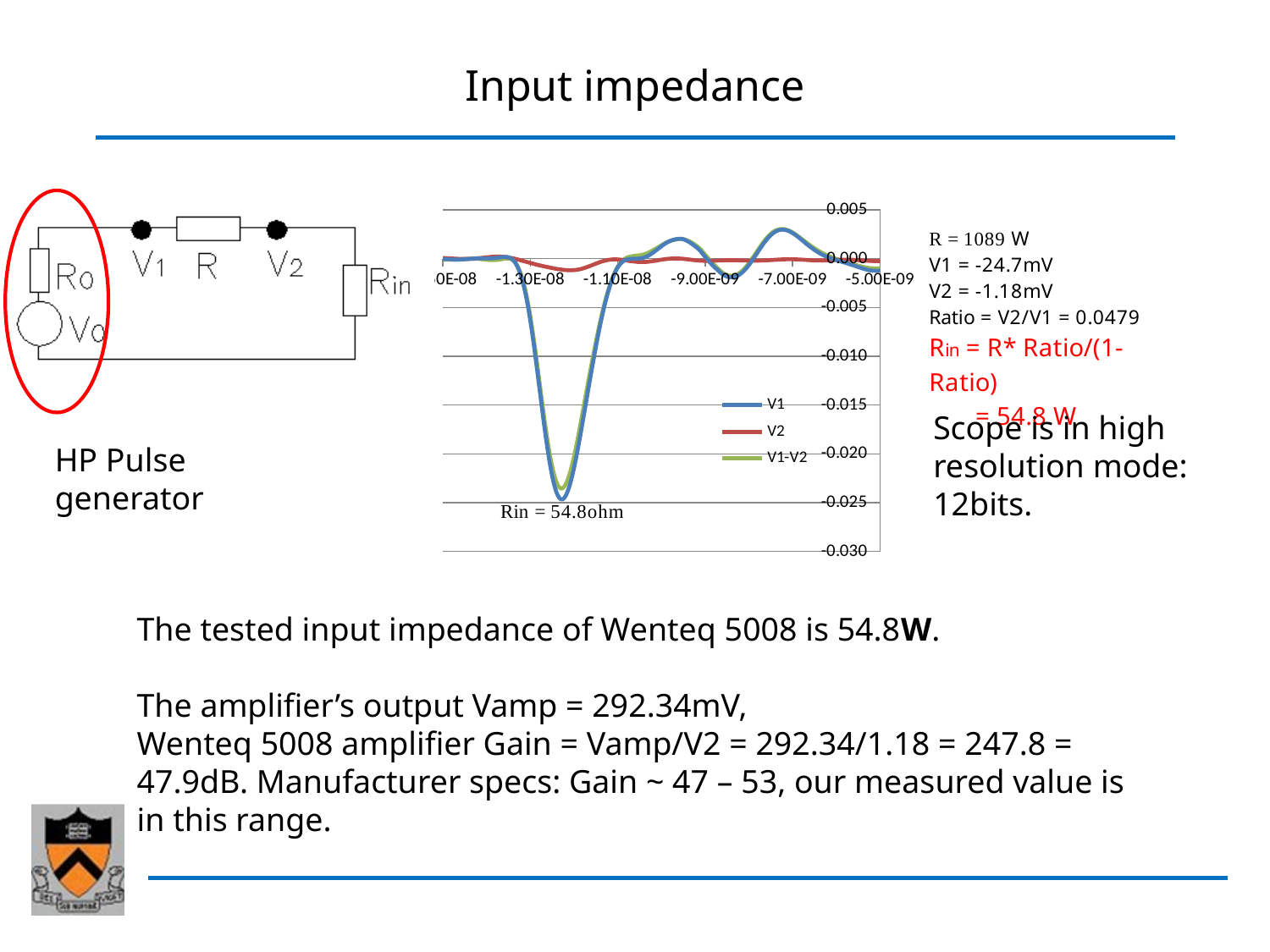
What kind of chart is shown on the slide? line chart Is the lowest value reached by the V2 line greater or less than -0.005? greater Is the value of the V1 line at -1.10E-08 greater or less than -0.005? greater What colour is the V2 line in the chart? red What are the series names listed in the chart's legend? V1, V2, V1-V2 How many series does the chart's legend list? 3 Is the lowest value reached by the V1 line greater or less than -0.020? less Which series reaches a lower minimum value, V1 or V2? V1 Which series stays closest to 0.000 across the whole x axis? V2